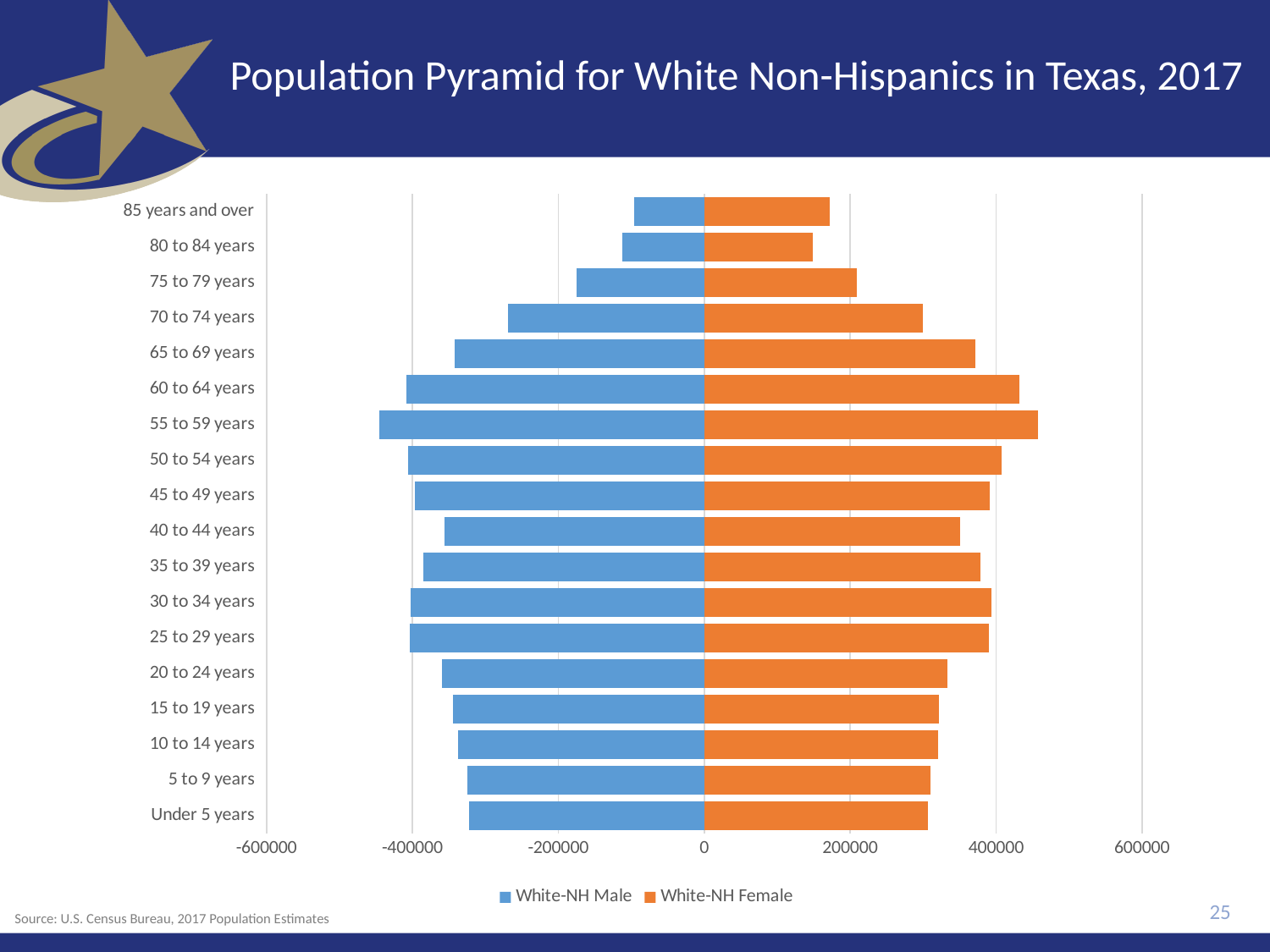
What colour represents White-NH Female in the chart? Orange Which is larger for White-NH Female: 65 to 69 years or 75 to 79 years? 65 to 69 years Which age group has the shortest White-NH Female bar? 80 to 84 years Moving from 55 to 59 years up to 85 years and over, do the White-NH Female values rise or fall? Fall Is the value for White-NH Female in 85 years and over greater or less than 200000? less How many age groups are shown on the chart? 18 Is the value for White-NH Female in 70 to 74 years greater or less than 200000? greater How many series does the legend list? 2 Which age group has the longest White-NH Female bar? 55 to 59 years What kind of chart is shown on the slide? Bar chart Which age group has the longest White-NH Male bar? 55 to 59 years Is the value for White-NH Female in 55 to 59 years greater or less than 400000? greater